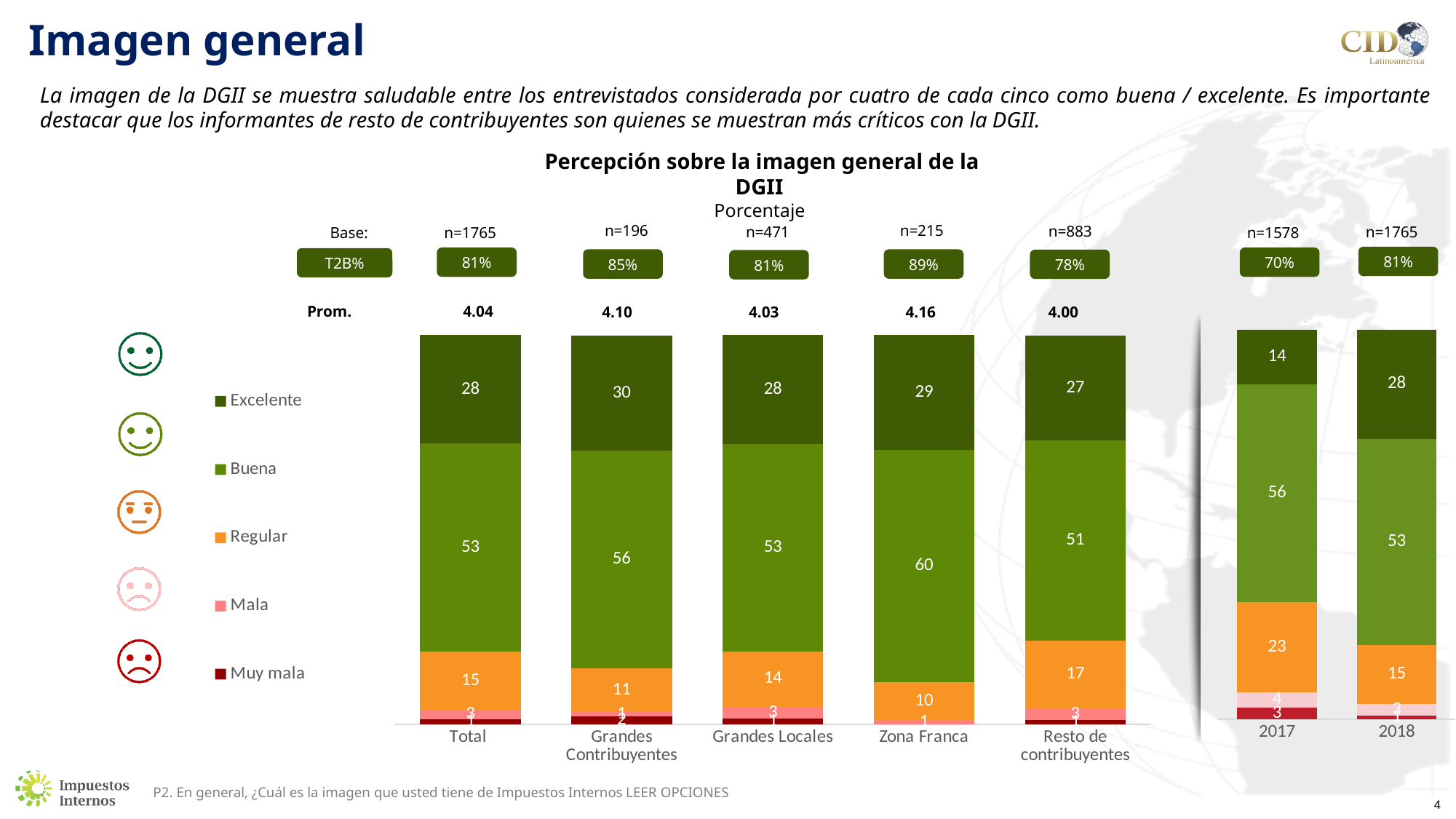
What kind of chart is shown on the slide? stacked bar chart Which category has the highest Buena value? Zona Franca What is the Excelente value for 2017? 14 Which category has the lowest Excelente value? 2017 What is the Prom. value shown for Resto de contribuyentes? 4.00 How many series does the legend list? 5 What is the difference between the Regular value for 2017 and for 2018? 8 What is the Buena value for Grandes Contribuyentes? 56 What is the Excelente value for Zona Franca? 29 Which is larger, the Excelente value for Grandes Contribuyentes or for Resto de contribuyentes? Grandes Contribuyentes What is the Regular value for Resto de contribuyentes? 17 What is the T2B% value shown for Zona Franca? 89%